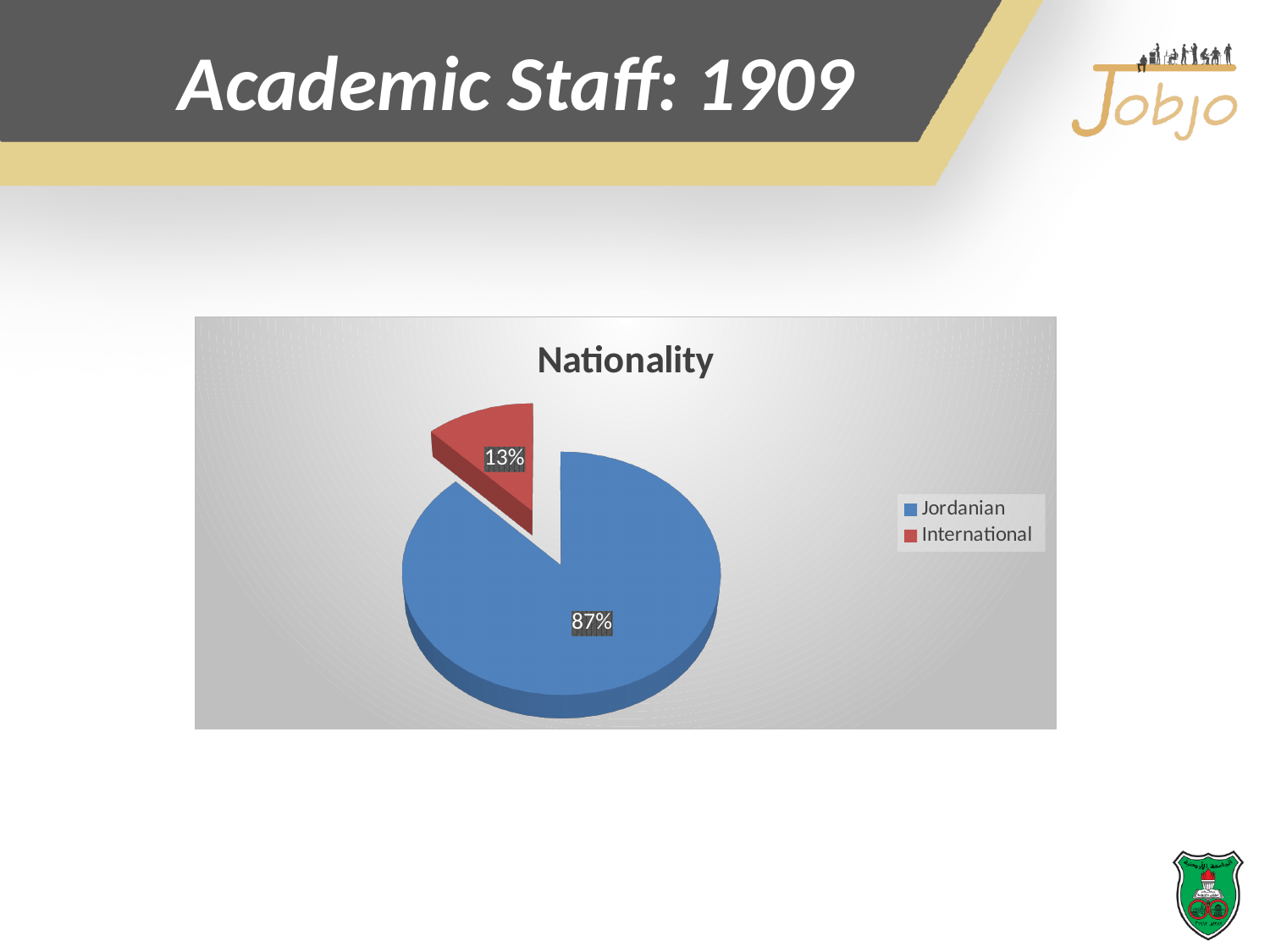
How many categories does the pie chart show? 2 What share of the pie is Jordanian? 87% What is the difference in percentage points between the Jordanian and International slices? 74 What colour is the International slice? Red What share of the pie is International? 13% What is the title of the chart? Nationality What type of chart is shown on the slide? Pie chart How many entries does the legend list? 2 Which category has the smallest slice of the pie? International Which category has the largest slice of the pie? Jordanian Which is larger, the Jordanian slice or the International slice? Jordanian